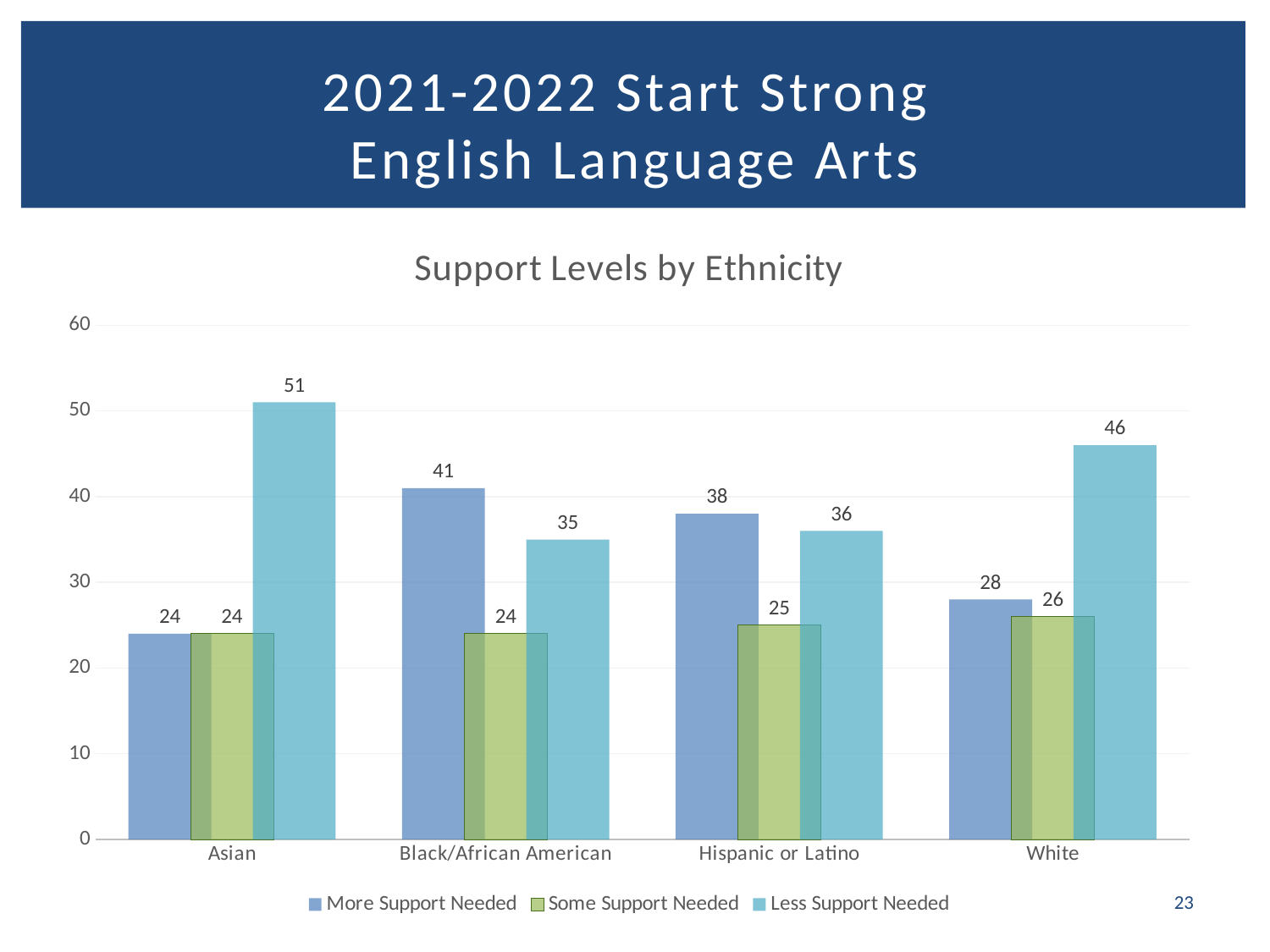
Which is larger: More Support Needed for Hispanic or Latino or More Support Needed for White? Hispanic or Latino Which ethnicity has the highest value for More Support Needed? Black/African American What is the value for Some Support Needed for Hispanic or Latino students? 25 What is the value for Less Support Needed for Asian students? 51 How many ethnicity categories are shown on the x axis? 4 What is the total of the three support levels for White students? 100 What kind of chart is shown? Bar chart What is the difference between Less Support Needed for Asian and for White students? 5 What is the title of the chart? Support Levels by Ethnicity What is the value for More Support Needed for Black/African American students? 41 Which ethnicity has the lowest value for Less Support Needed? Black/African American How many series does the legend list? 3